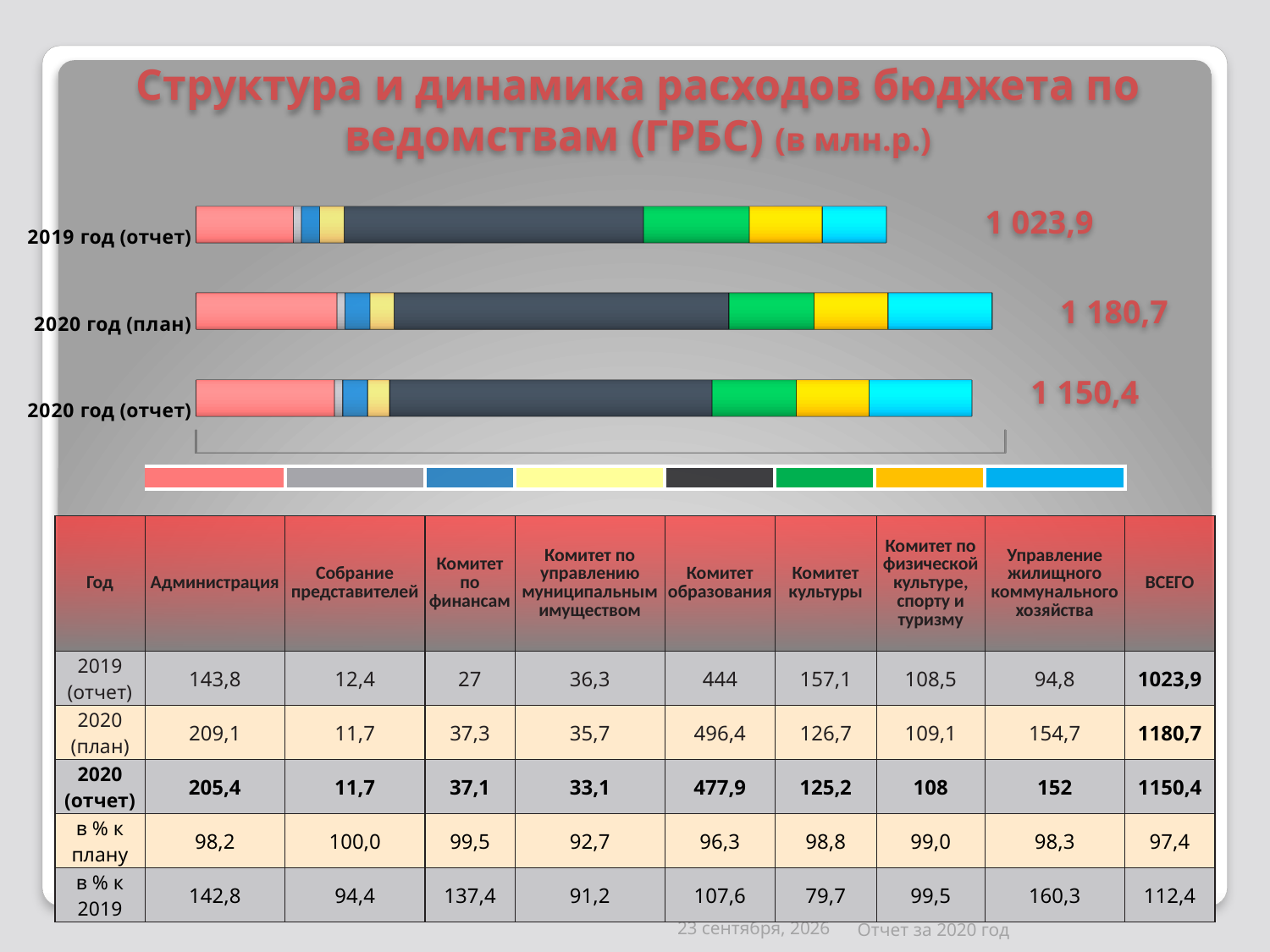
What type of chart is shown on the slide? stacked bar chart What total value is printed next to the bar for 2019 год (отчет)? 1 023,9 Which is larger, the total for 2020 год (план) or for 2020 год (отчет)? 2020 год (план) How many bars (years) are plotted in the chart? 3 Which category forms the largest segment in each bar, according to the table? Комитет образования What total value is printed next to the bar for 2020 год (отчет)? 1 150,4 Which bar has the smallest total? 2019 год (отчет) What total value is printed next to the bar for 2020 год (план)? 1 180,7 Which bar has the largest total? 2020 год (план) What is the difference between the totals for 2020 год (план) and 2019 год (отчет)? 156,8 What is the value for Комитет образования in 2020 (отчет), as shown in the table? 477,9 How many colour entries does the chart legend show? 8